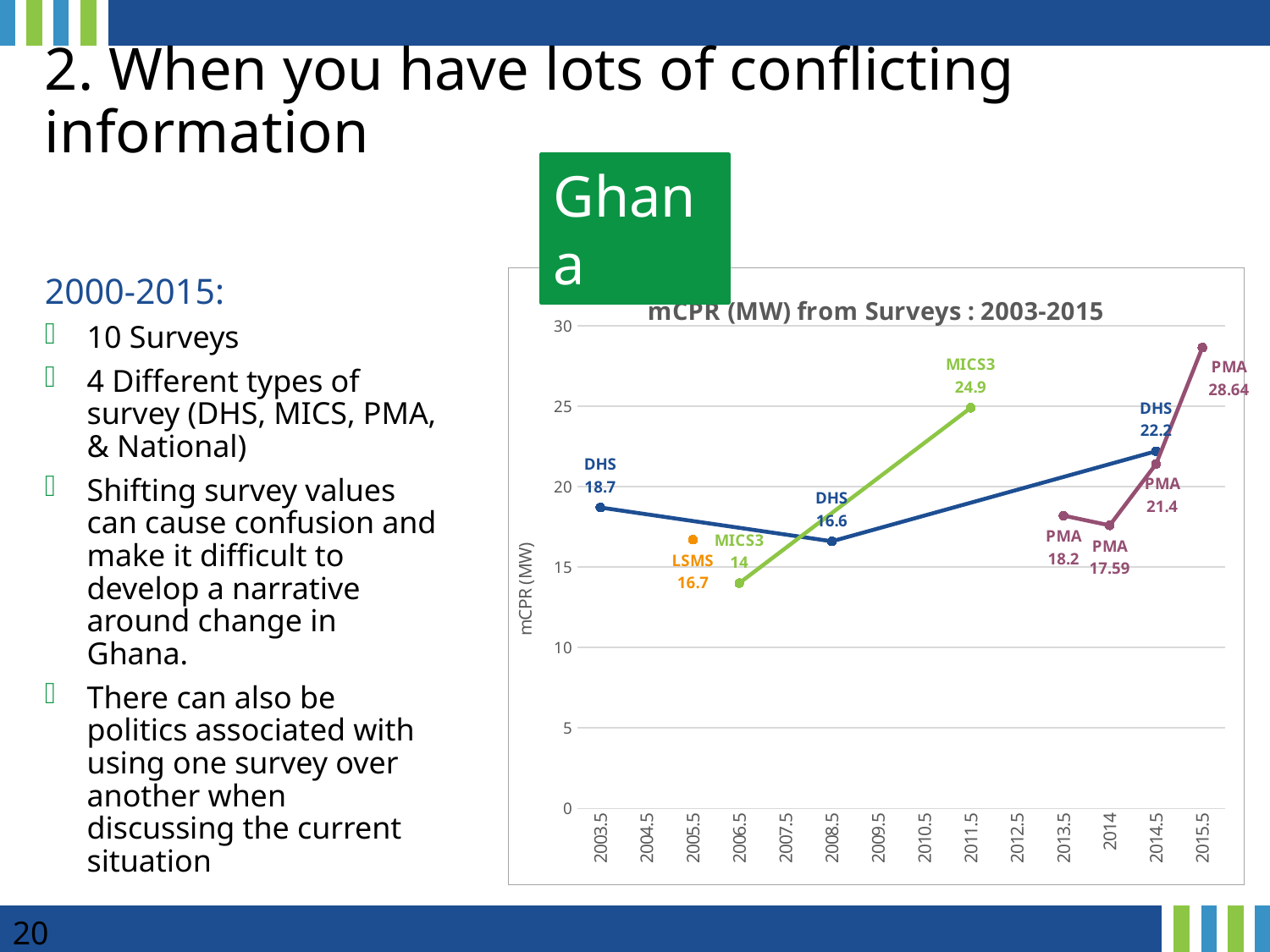
What is the title of the chart? mCPR (MW) from Surveys : 2003-2015 How many survey data points are plotted on the chart? 10 Which survey point has the highest mCPR value on the chart? PMA 28.64 What is the difference between the DHS value at 2014.5 (22.2) and the DHS value at 2003.5 (18.7)? 3.5 What is the mCPR value labelled for the MICS3 survey at 2011.5? 24.9 What is the label on the vertical axis of the chart? mCPR (MW) What is the mCPR value labelled for the DHS survey at 2003.5? 18.7 Which is larger, the PMA value at 2013.5 or the PMA value at 2014? PMA at 2013.5 (18.2) What type of chart is shown on the slide? line chart What is the mCPR value labelled for the PMA survey at 2015.5? 28.64 Which survey point has the lowest mCPR value on the chart? MICS3 14 What is the mCPR value labelled for the LSMS survey? 16.7